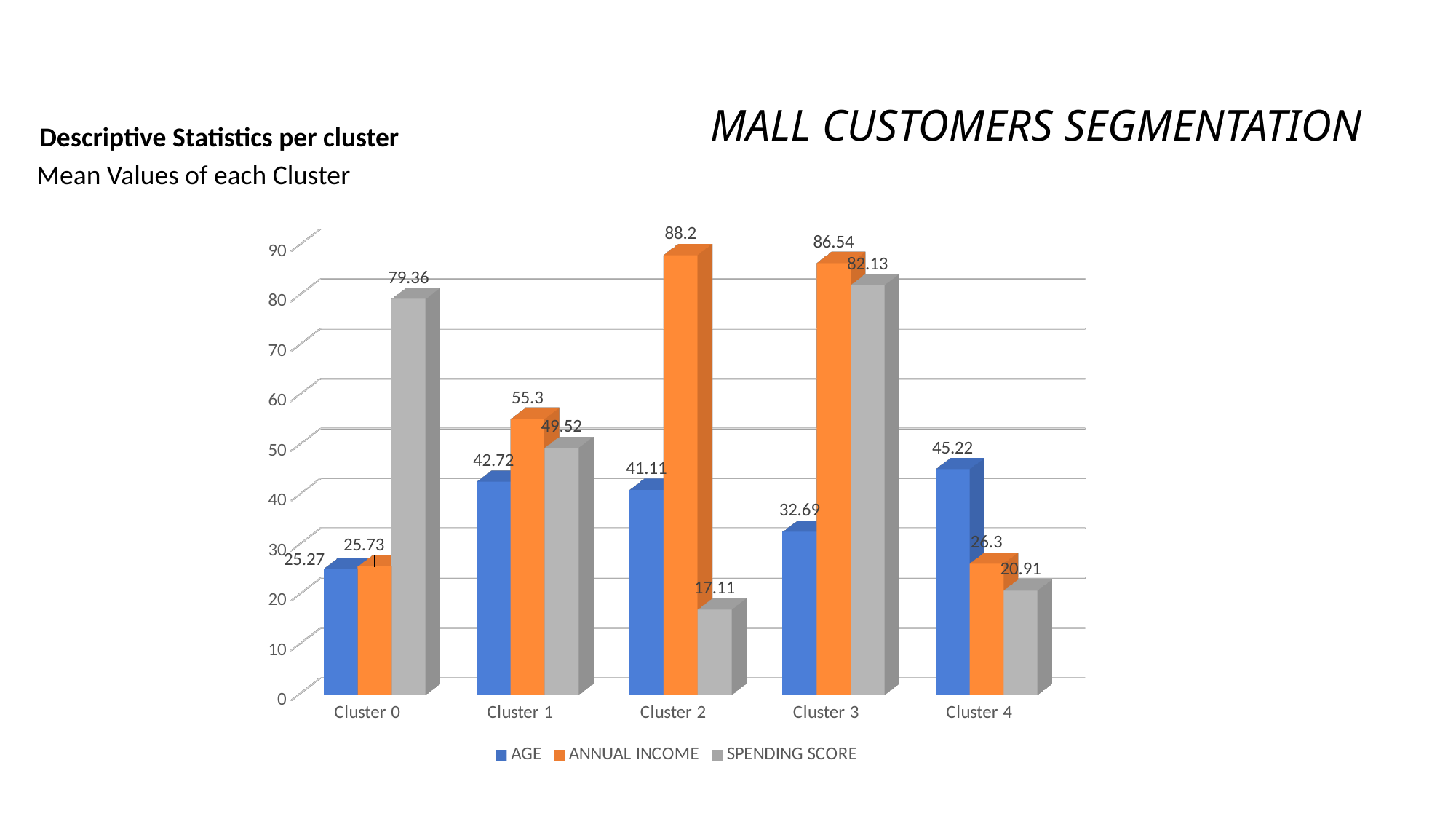
What is the mean AGE value for Cluster 1? 42.72 Which cluster has the highest AGE value? Cluster 4 Which is larger for Cluster 1: ANNUAL INCOME or SPENDING SCORE? ANNUAL INCOME Which cluster has the highest ANNUAL INCOME value? Cluster 2 What kind of chart is shown on the slide? Bar chart What is the difference between the SPENDING SCORE of Cluster 3 and the SPENDING SCORE of Cluster 2? 65.02 Which cluster has the lowest SPENDING SCORE value? Cluster 2 What is the SPENDING SCORE value for Cluster 0? 79.36 What is the ANNUAL INCOME value for Cluster 2? 88.2 How many clusters are shown on the x axis? 5 How many series does the legend list? 3 What is the SPENDING SCORE value for Cluster 4? 20.91